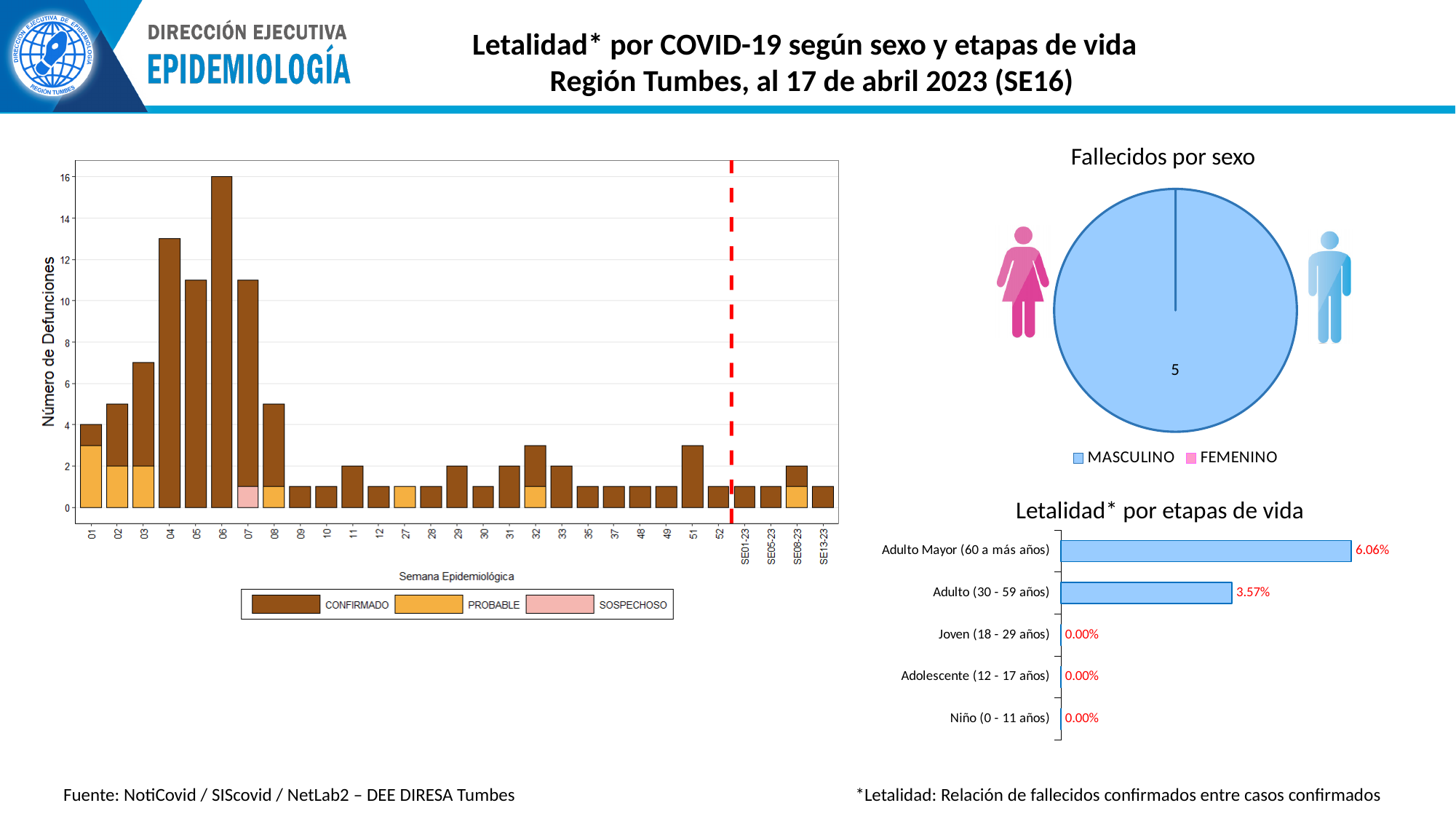
In the left chart of deaths by Semana Epidemiológica, is the total for week 04 greater or less than 12? greater In the 'Letalidad* por etapas de vida' chart, what is the value for Joven (18 - 29 años)? 0.00% In the 'Letalidad* por etapas de vida' chart, what is the value for Adulto Mayor (60 a más años)? 6.06% In the 'Letalidad* por etapas de vida' chart, which age group has the highest lethality? Adulto Mayor (60 a más años) In the 'Letalidad* por etapas de vida' chart, how many age groups are shown? 5 What kind of chart is 'Fallecidos por sexo'? Pie chart In the 'Letalidad* por etapas de vida' chart, what is the value for Adulto (30 - 59 años)? 3.57% In the 'Fallecidos por sexo' pie chart, what value is shown for MASCULINO? 5 How many entries does the legend of the 'Fallecidos por sexo' chart list? 2 In the left chart of deaths by Semana Epidemiológica, how many series does the legend list? 3 In the 'Letalidad* por etapas de vida' chart, what is the difference between the values for Adulto Mayor (60 a más años) and Adulto (30 - 59 años)? 2.49% In the left chart of deaths by Semana Epidemiológica, which week has the highest number of deaths? 06